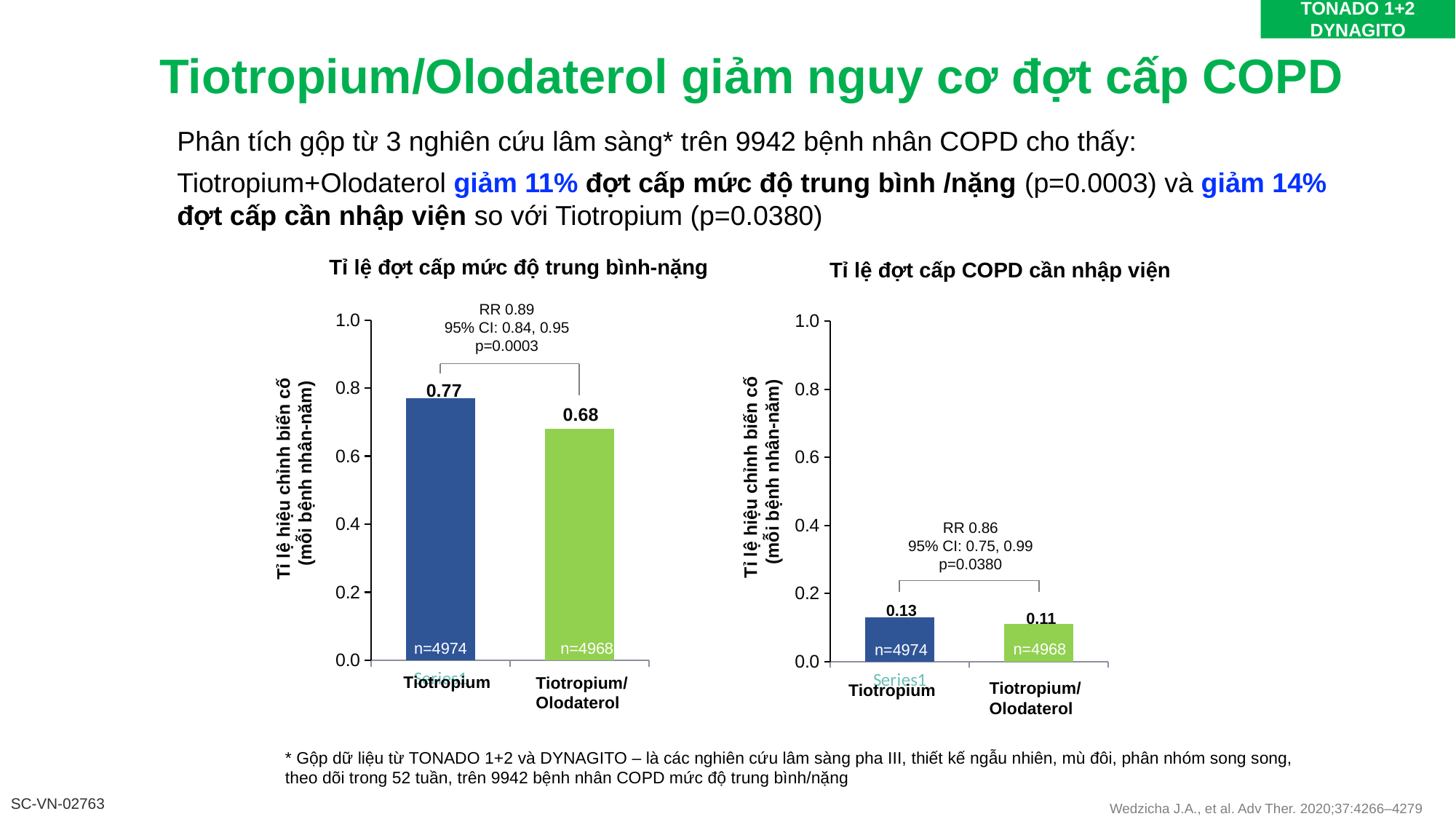
In the left chart (Tỉ lệ đợt cấp mức độ trung bình-nặng), what colour is the Tiotropium/Olodaterol bar? Green In the right chart (Tỉ lệ đợt cấp COPD cần nhập viện), what is the value for Tiotropium/Olodaterol? 0.11 In the left chart (Tỉ lệ đợt cấp mức độ trung bình-nặng), which category has the higher value? Tiotropium In the right chart (Tỉ lệ đợt cấp COPD cần nhập viện), what is the value for Tiotropium? 0.13 In the left chart (Tỉ lệ đợt cấp mức độ trung bình-nặng), what is the value for Tiotropium? 0.77 In the left chart (Tỉ lệ đợt cấp mức độ trung bình-nặng), what is the difference between the Tiotropium and Tiotropium/Olodaterol values? 0.09 In the left chart (Tỉ lệ đợt cấp mức độ trung bình-nặng), what is the value for Tiotropium/Olodaterol? 0.68 In the right chart (Tỉ lệ đợt cấp COPD cần nhập viện), what is the difference between the Tiotropium and Tiotropium/Olodaterol values? 0.02 In the left chart (Tỉ lệ đợt cấp mức độ trung bình-nặng), is the value for Tiotropium/Olodaterol greater or less than 0.6? greater How many bars are plotted in the right chart (Tỉ lệ đợt cấp COPD cần nhập viện)? 2 In the right chart (Tỉ lệ đợt cấp COPD cần nhập viện), which category has the lower value? Tiotropium/Olodaterol What type of chart is the left chart (Tỉ lệ đợt cấp mức độ trung bình-nặng)? Bar chart